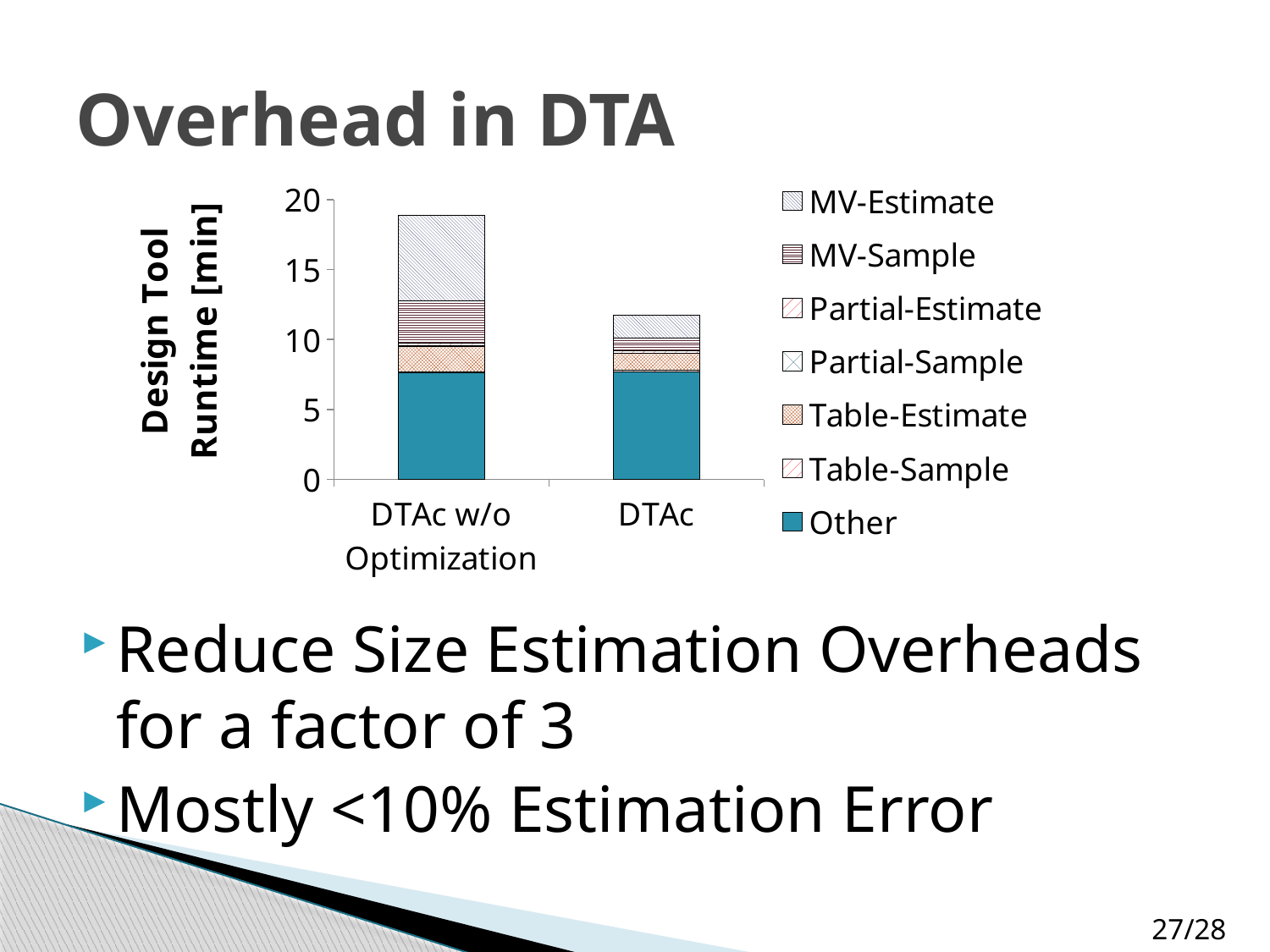
Is the 'Other' segment for DTAc w/o Optimization greater or less than 10? less How many series does the chart's legend list? 7 What kind of chart is shown on the slide? stacked bar chart Which category has the taller stacked bar? DTAc w/o Optimization How many categories are shown on the x axis of the chart? 2 What is the title of the chart's vertical axis? Design Tool Runtime [min] Is the 'Other' segment for DTAc greater or less than 5? greater Is the total bar height for DTAc w/o Optimization greater or less than 15? greater Which category has the shorter stacked bar? DTAc Which legend entry is shown as a solid filled segment at the bottom of each bar? Other